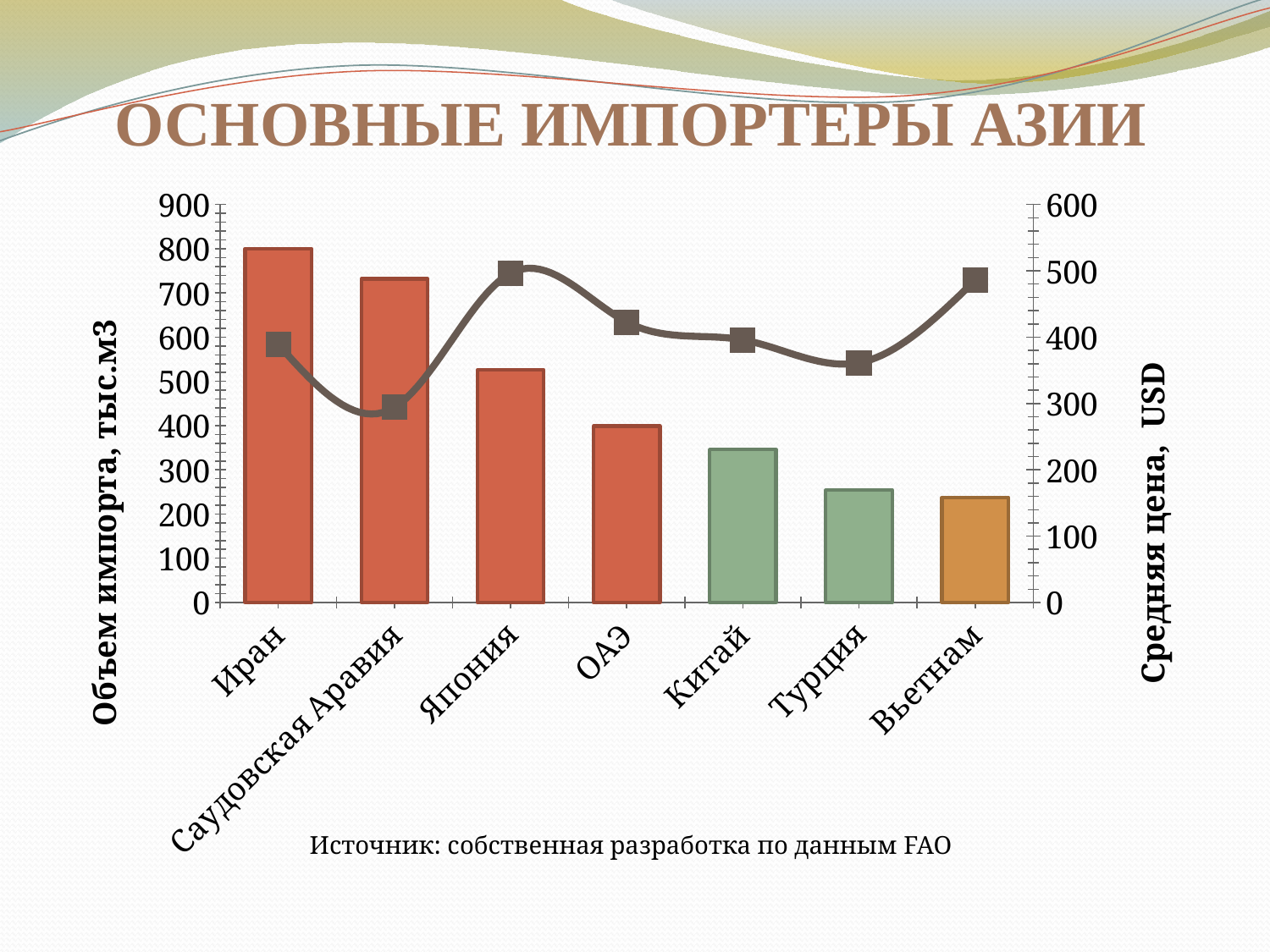
Is the average price (line) for Япония greater or less than 400 USD? greater Is the average price (line) for Саудовская Аравия greater or less than 400 USD? less Is the import volume bar for Иран greater or less than 700? greater What is the label of the left vertical axis? Объем импорта, тыс.м3 Which has the larger import volume bar, Иран or Япония? Иран How many countries are shown on the x axis of the chart? 7 Which country has the lowest average price on the line series? Саудовская Аравия Do the import volume bars rise or fall from left to right across the countries? fall Which country has the highest import volume (tallest bar)? Иран What kind of chart is shown on the slide? Combined bar and line chart